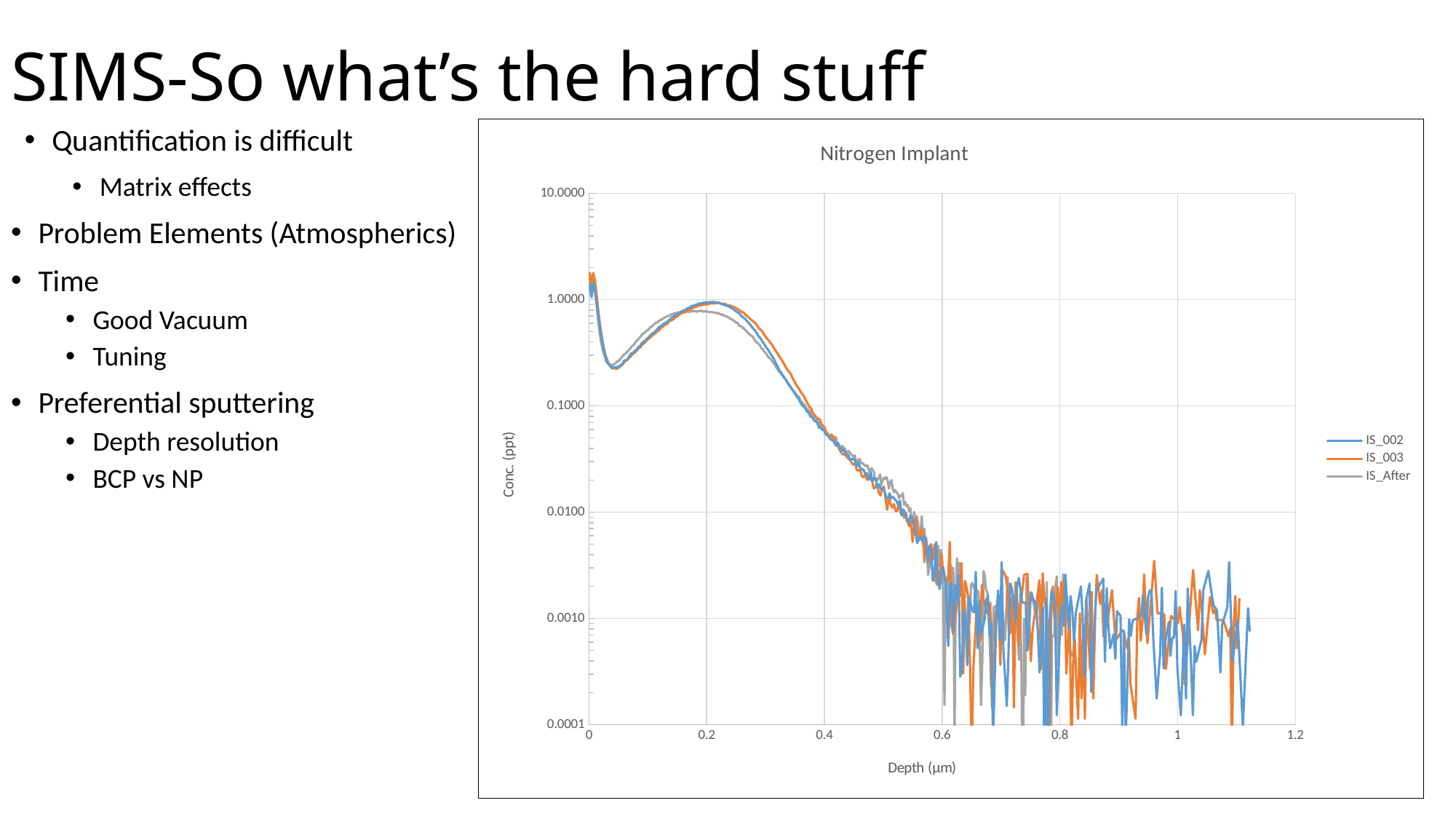
Which series has the lowest peak concentration around a depth of 0.2 µm? IS_After Do the concentration values rise or fall along the x axis between depths of 0.2 µm and 0.6 µm? fall How many series does the legend of the Nitrogen Implant chart list? 3 What is the title of the chart on the slide? Nitrogen Implant What are the names of the three series in the chart's legend? IS_002, IS_003, IS_After Is the value of IS_002 at a depth of 0.4 µm greater or less than 0.1000? less How many labelled tick marks are shown on the x axis (Depth) of the chart? 7 Is the value of IS_002 at a depth of 0.05 µm greater or less than 1.0000? less What kind of chart is shown on the slide? line chart Is the value of IS_003 at a depth of 0 µm greater or less than 1.0000? greater At a depth of 0.3 µm, which series has the larger value, IS_003 or IS_After? IS_003